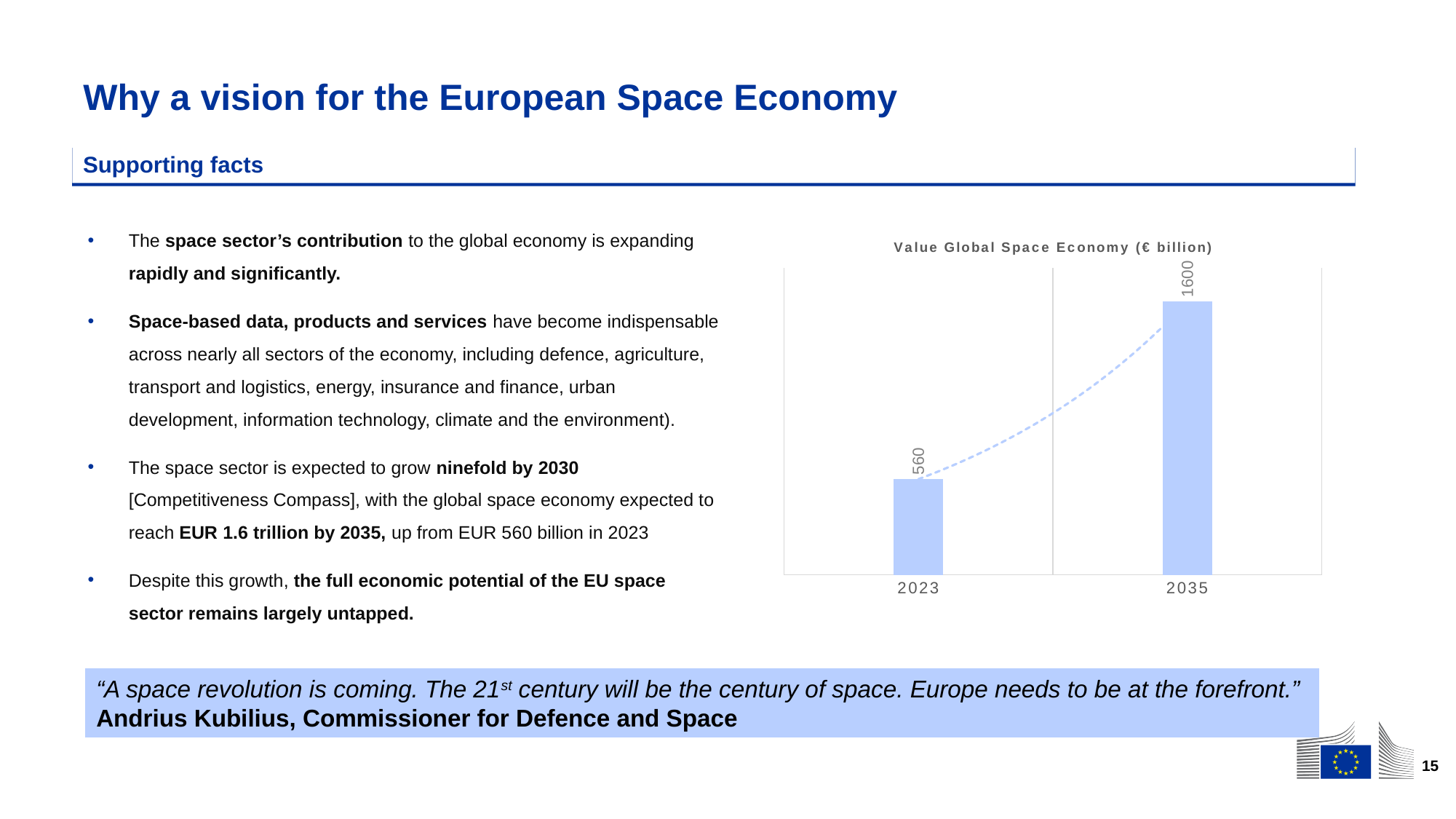
Do the values rise or fall from 2023 to 2035? rise How many years are shown on the x axis of the chart? 2 Which year has the lower value in the chart? 2023 What is the difference between the 2035 and 2023 values in the chart? 1040 Which year has the higher value in the chart? 2035 What unit is stated in the chart title? € billion What is the title of the chart? Value Global Space Economy (€ billion) What is the value for 2035 in the chart? 1600 What is the value for 2023 in the chart? 560 Is the value for 2035 larger or smaller than the value for 2023? larger What kind of chart is shown on the slide? bar chart